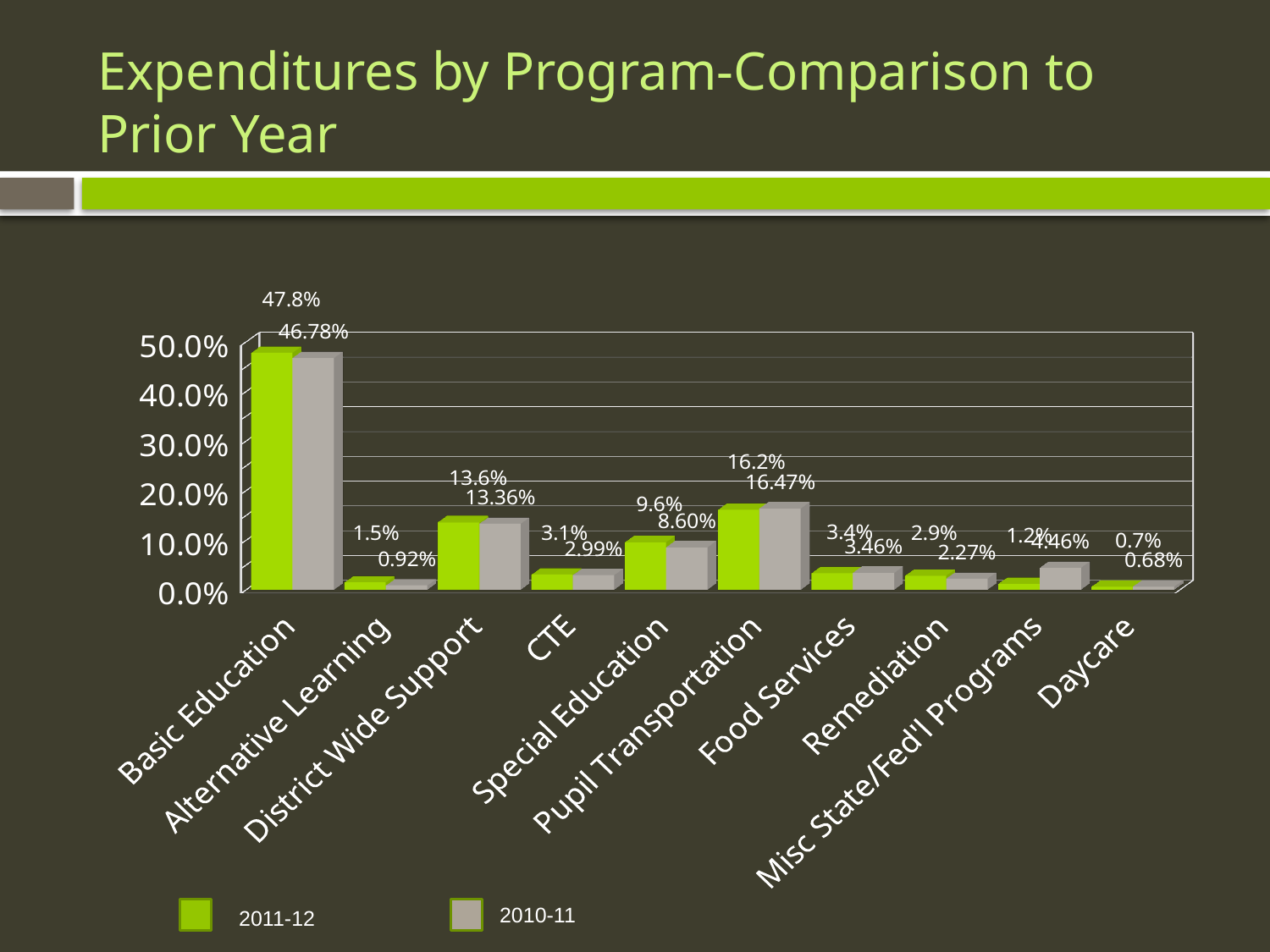
How many series does the legend list? 2 What is the 2010-11 value for Pupil Transportation? 16.47% What is the 2011-12 value for Basic Education? 47.8% What is the 2010-11 value for Alternative Learning? 0.92% For Pupil Transportation, which year has the larger value, 2011-12 or 2010-11? 2010-11 What kind of chart is shown on the slide? Bar chart Which program has the lowest 2011-12 expenditure share? Daycare What are the two entries in the legend? 2011-12 and 2010-11 What is the difference between the 2011-12 and 2010-11 values for Basic Education? 1.02 percentage points For Special Education, which year has the larger value, 2011-12 or 2010-11? 2011-12 Which program has the highest 2011-12 expenditure share? Basic Education How many program categories are shown on the x axis? 10